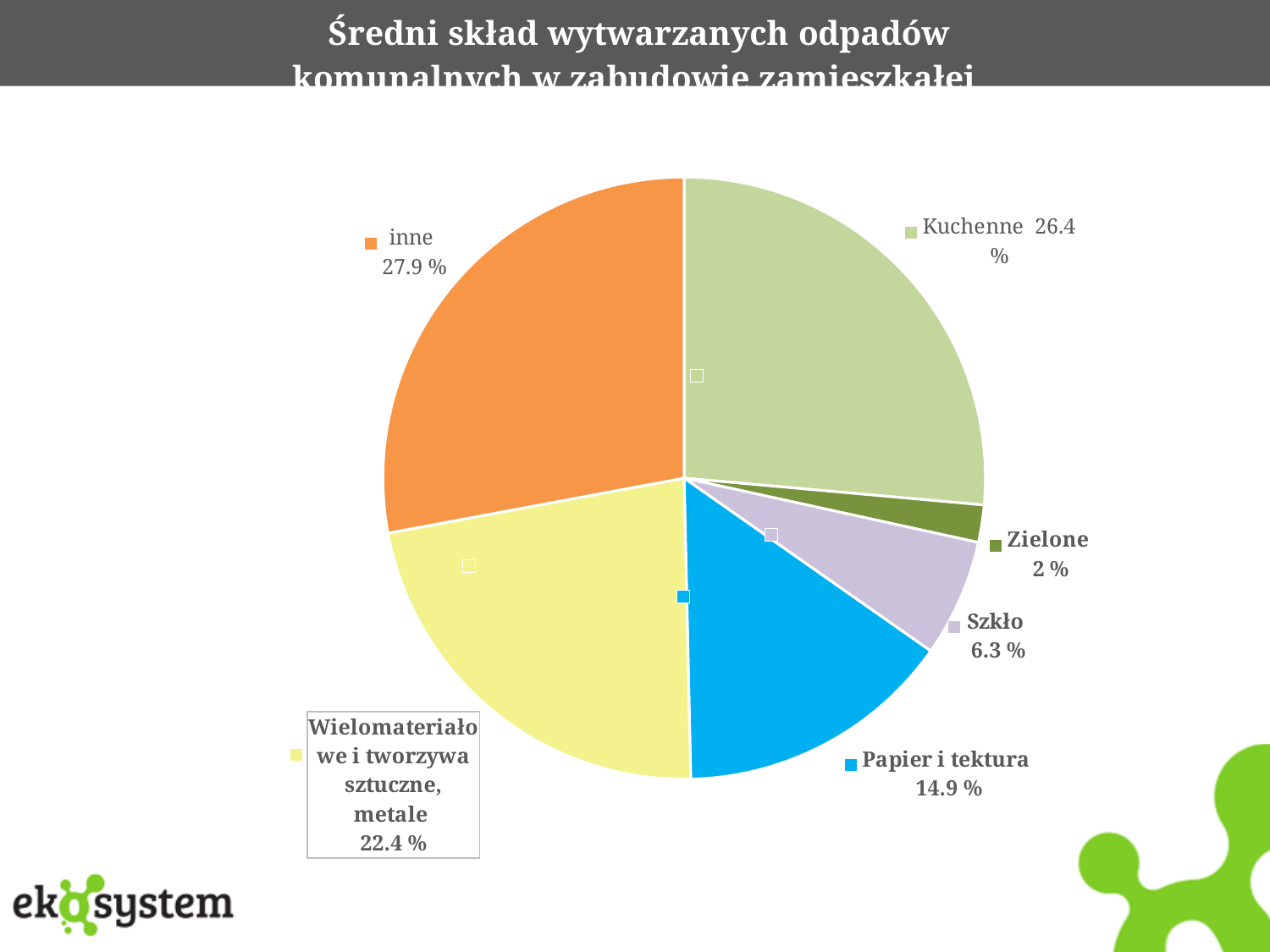
What is the share for "Kuchenne"? 26.4 % How many slices does the pie chart have? 6 Which category has the largest share of the pie? inne What is the share for "Szkło"? 6.3 % What colour is the "Papier i tektura" slice? blue What is the share for "Papier i tektura"? 14.9 % What is the difference between the shares of "inne" and "Kuchenne"? 1.5 % Which category has the smallest share of the pie? Zielone What kind of chart is shown on the slide? pie chart What is the difference between the shares of "Papier i tektura" and "Zielone"? 12.9 % What is the share for "Wielomateriałowe i tworzywa sztuczne, metale"? 22.4 % Which is larger, the share for "Papier i tektura" or the share for "Szkło"? Papier i tektura